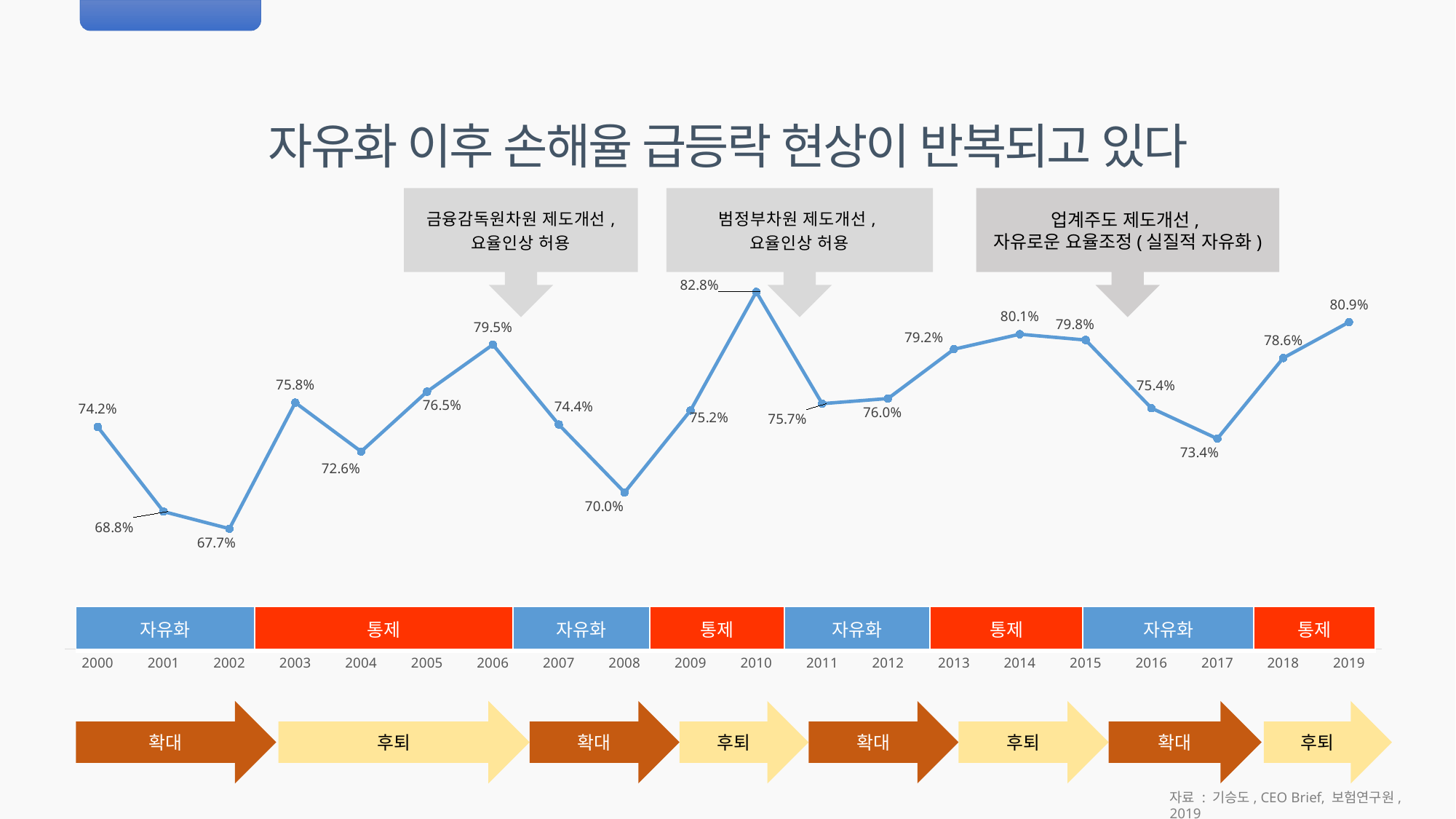
Do the values rise or fall from 2016 to 2017? fall What is the value for 2002? 67.7% What is the value for 2010? 82.8% How many data points are plotted on the line? 20 What kind of chart is shown? line chart Which year has the highest value? 2010 What is the difference between the values for 2010 and 2011? 7.1% Which year has the lowest value? 2002 What is the difference between the values for 2000 and 2001? 5.4% What is the value for 2019? 80.9% What is the value for 2008? 70.0% Which is larger, the value for 2006 or the value for 2007? 2006